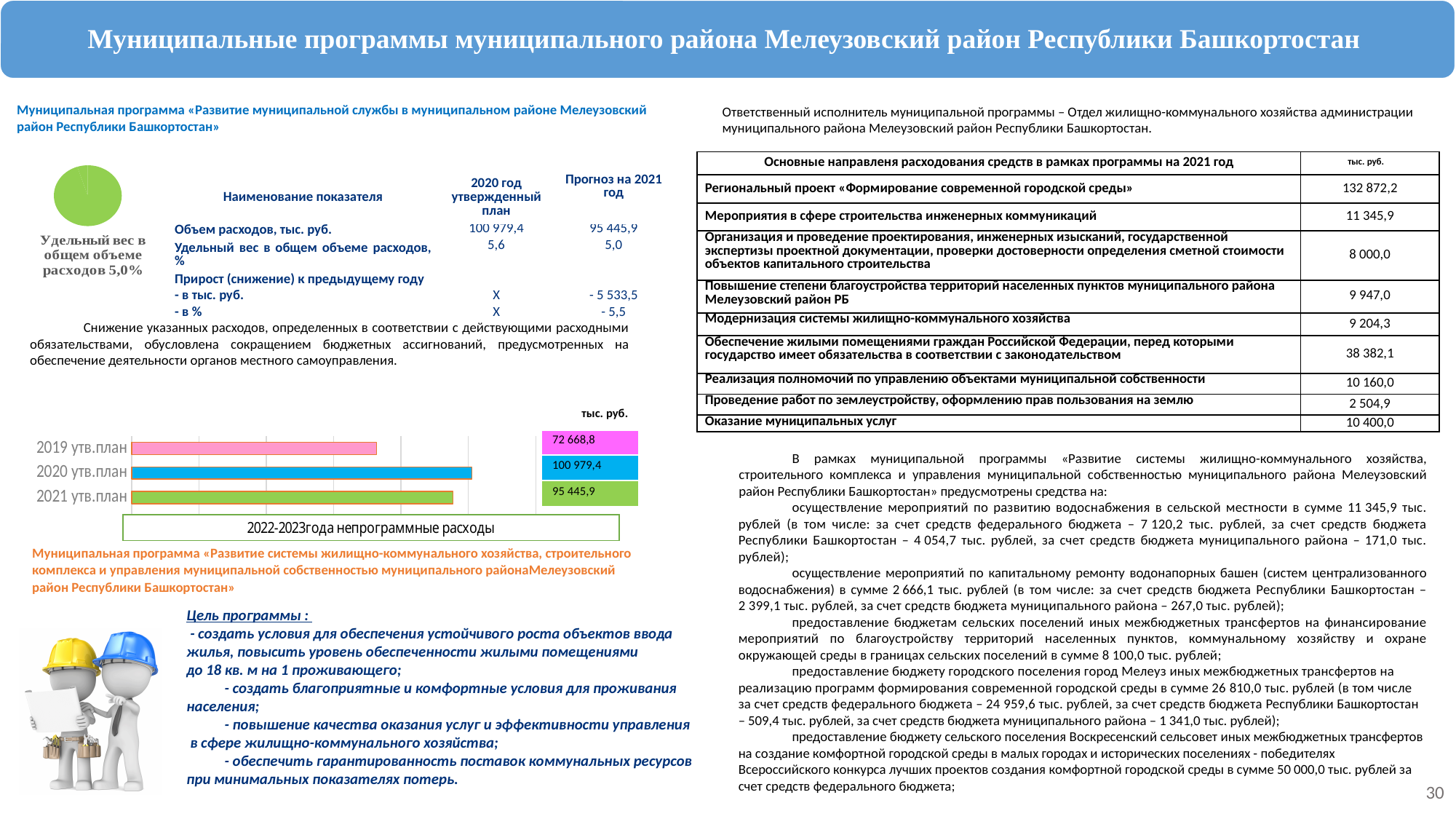
In the bar chart, what is the difference between the values for 2020 утв.план and 2021 утв.план? 5 533,5 What unit is indicated above the data labels of the bar chart? тыс. руб. In the bar chart, what is the difference between the values for 2020 утв.план and 2019 утв.план? 28 310,6 In the bar chart, which category has the lowest value? 2019 утв.план In the bar chart, does the value rise or fall from 2020 утв.план to 2021 утв.план? fall In the bar chart, what is the value for 2020 утв.план? 100 979,4 In the bar chart, which category has the highest value? 2020 утв.план In the bar chart, which is larger: the value for 2019 утв.план or 2021 утв.план? 2021 утв.план In the bar chart, what is the value for 2019 утв.план? 72 668,8 In the bar chart, what is the value for 2021 утв.план? 95 445,9 How many categories (bars) does the bar chart show? 3 What kind of chart shows the values for 2019, 2020 and 2021 утв.план? bar chart